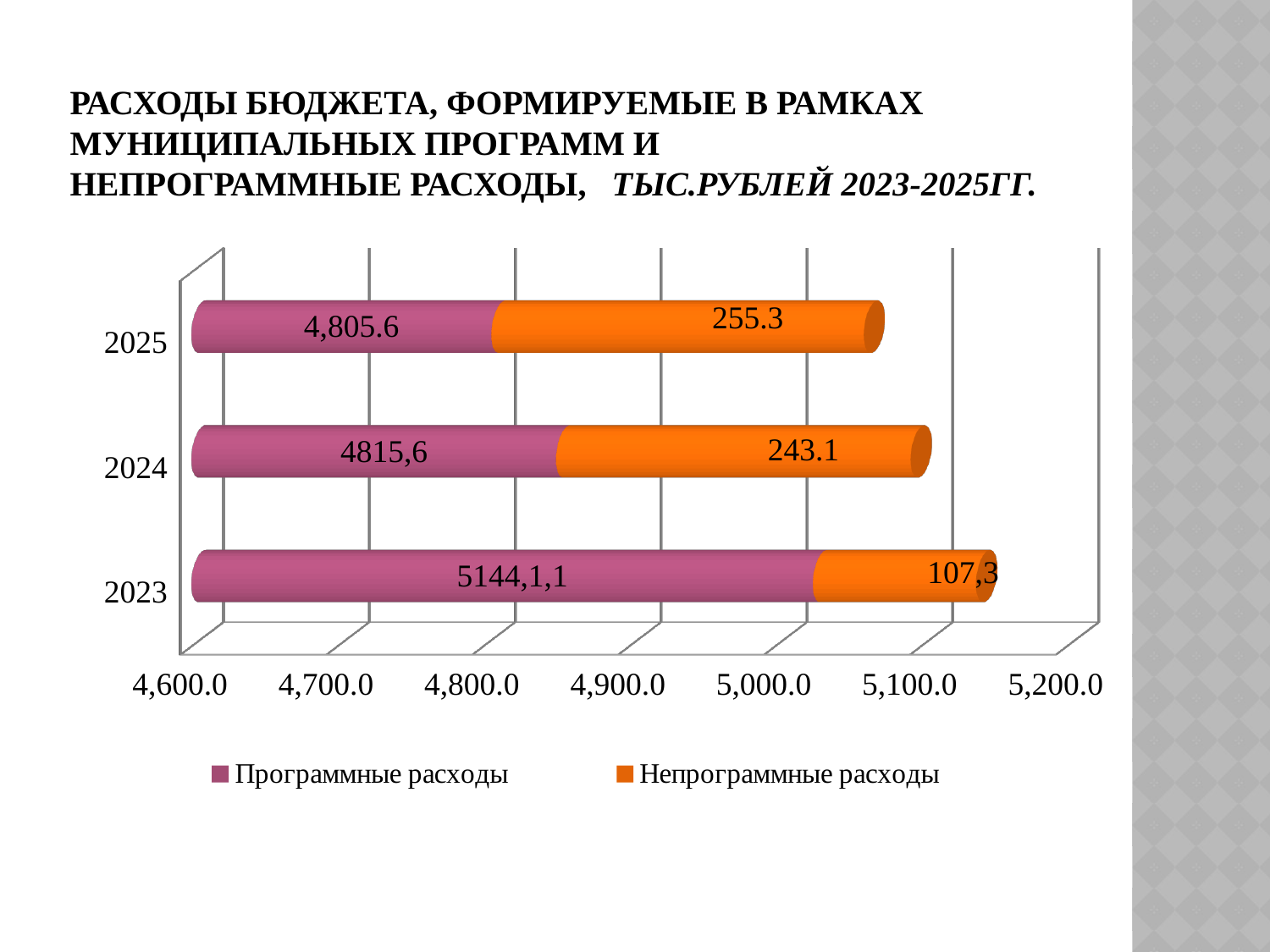
What is the value of Программные расходы for 2024? 4815,6 How many series does the legend list? 2 Which is larger, the Непрограммные расходы value for 2024 or for 2025? 2025 What is the value of Программные расходы for 2025? 4,805.6 Which colour represents Непрограммные расходы in the chart? Orange What is the value of Непрограммные расходы for 2024? 243.1 What is the value of Непрограммные расходы for 2023? 107,3 How many years are shown on the chart? 3 Which year has the highest value for Непрограммные расходы? 2025 What is the difference between the Непрограммные расходы values for 2025 and 2024? 12.2 Which year has the lowest value for Непрограммные расходы? 2023 What kind of chart is shown on the slide? Bar chart